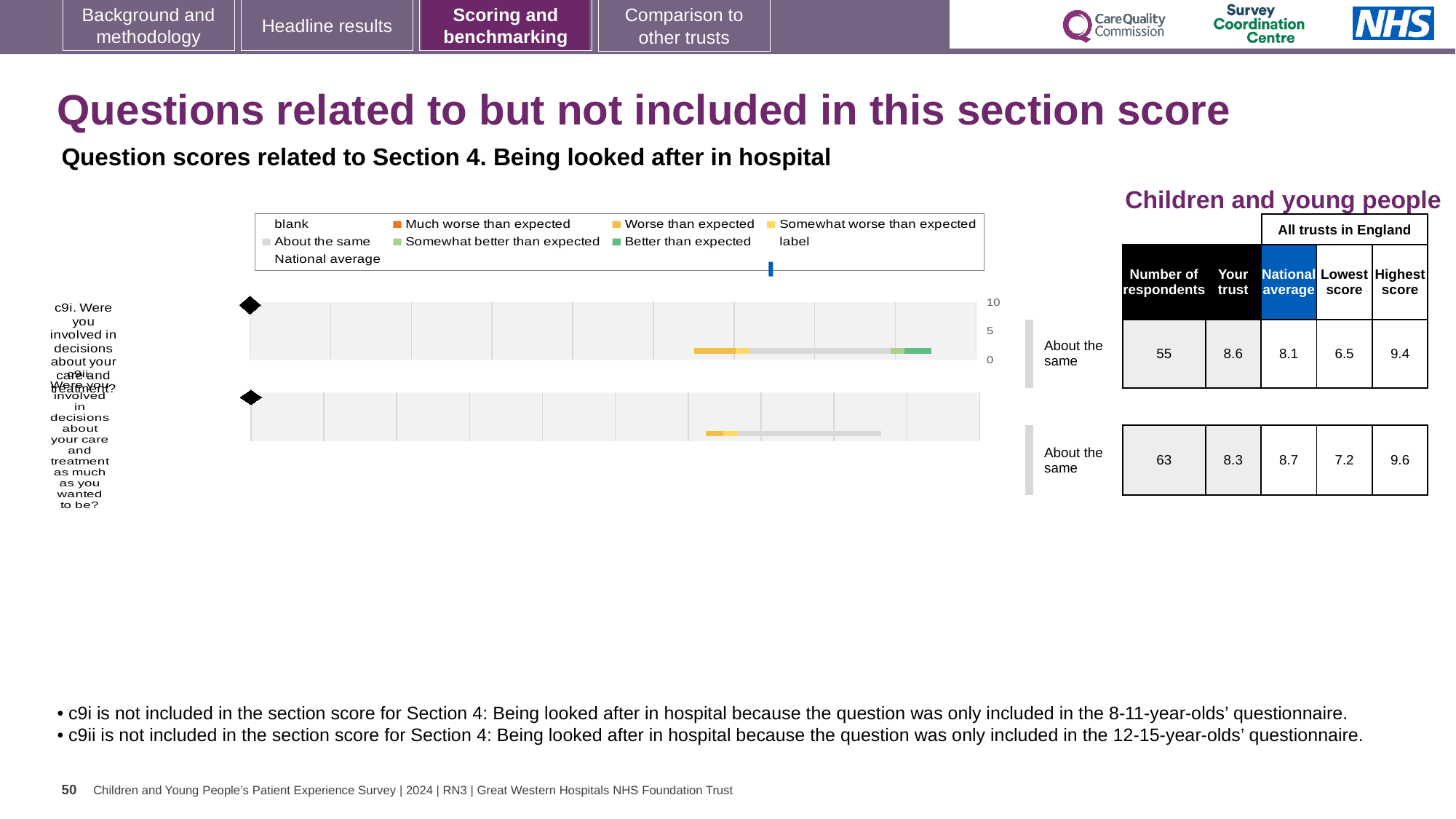
For question c9i, which is larger: the 'Your trust' score or the national average? Your trust What is the national average score for question c9ii? 8.7 How many respondents answered question c9i? 55 What benchmark category is shown next to the bar for question c9i? About the same How many questions (categories) are plotted in the chart? 2 What is the maximum value shown on the chart's score axis? 10 What kind of chart is shown on the slide? bar chart What is the difference between the highest score (9.4) and the lowest score (6.5) for question c9i? 2.9 For question c9ii, what is the difference between the national average (8.7) and the 'Your trust' score (8.3)? 0.4 Which question has the larger number of respondents, c9i or c9ii? c9ii What is the highest score among all trusts in England for question c9ii? 9.6 What is the 'Your trust' score for question c9i? 8.6